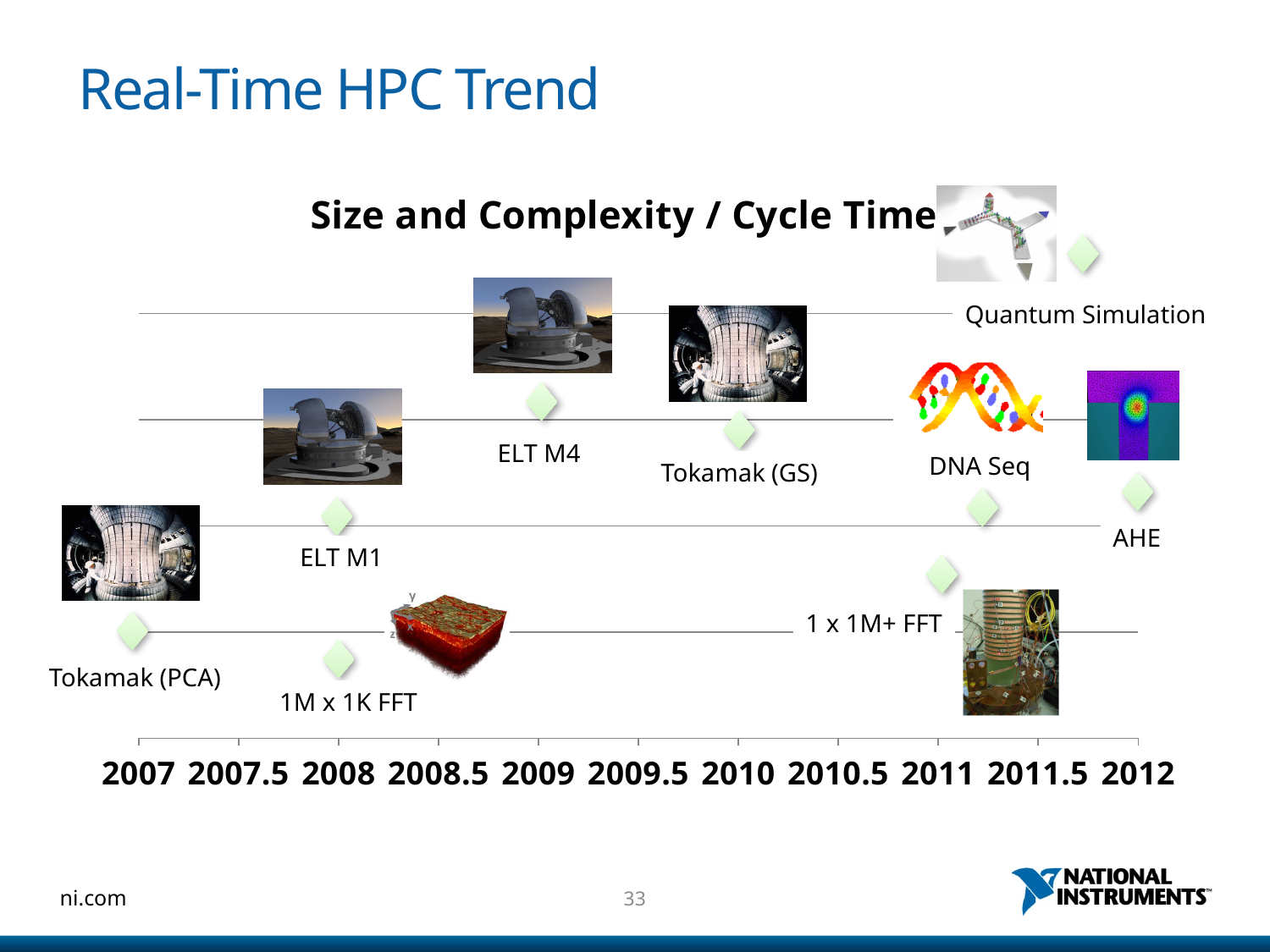
What kind of chart is shown on the slide? scatter chart Is the x-axis position of Tokamak (GS) greater or less than 2009.5? greater Which data point is plotted highest on the chart? Quantum Simulation Is the x-axis position of ELT M4 greater or less than 2008.5? greater Which data point is plotted latest on the x axis? AHE Which is plotted higher on the chart, ELT M4 or ELT M1? ELT M4 Is the x-axis position of Tokamak (PCA) greater or less than 2008? less How many labeled data points are plotted on the chart? 9 What is the title of the chart? Size and Complexity / Cycle Time Which data point is plotted earliest on the x axis? Tokamak (PCA) Which is plotted higher on the chart, Tokamak (GS) or Tokamak (PCA)? Tokamak (GS) Do the plotted points generally rise or fall as the year increases along the x axis? rise